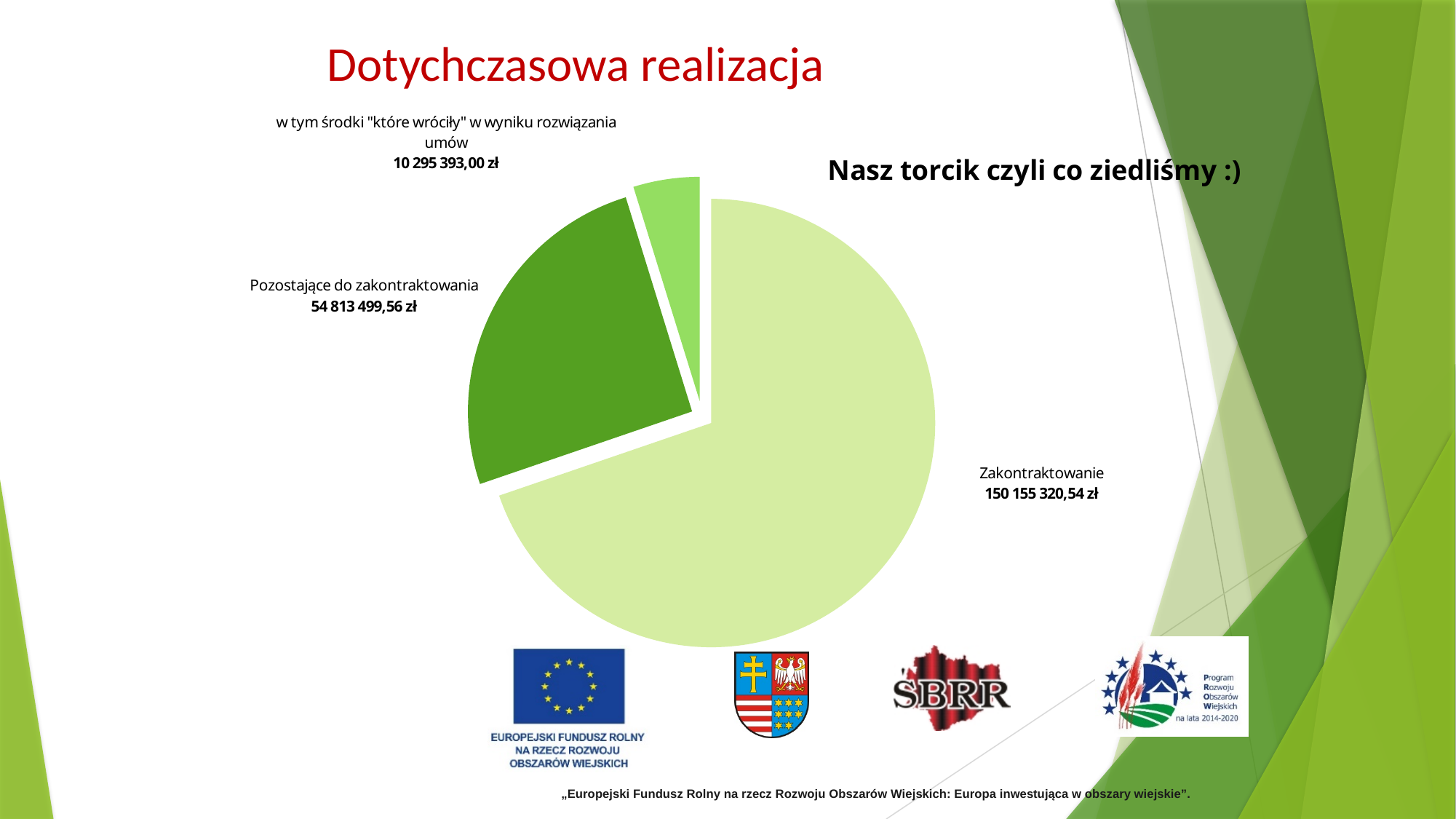
What is the value for Zakontraktowanie? 150 155 320,54 zł How many slices does the pie chart have? 3 Which is larger: Zakontraktowanie or Pozostające do zakontraktowania? Zakontraktowanie What is the title of the pie chart? Nasz torcik czyli co ziedliśmy :) Which slice of the pie chart is the largest? Zakontraktowanie What is the difference between Pozostające do zakontraktowania and the slice for środki "które wróciły" w wyniku rozwiązania umów? 44 518 106,56 zł Which slice of the pie chart is the smallest? w tym środki "które wróciły" w wyniku rozwiązania umów What is the difference between Zakontraktowanie and Pozostające do zakontraktowania? 95 341 820,98 zł What is the value for Pozostające do zakontraktowania? 54 813 499,56 zł What is the value for the slice labelled 'w tym środki "które wróciły" w wyniku rozwiązania umów'? 10 295 393,00 zł What colour is the Zakontraktowanie slice? light green What kind of chart is shown on the slide? pie chart